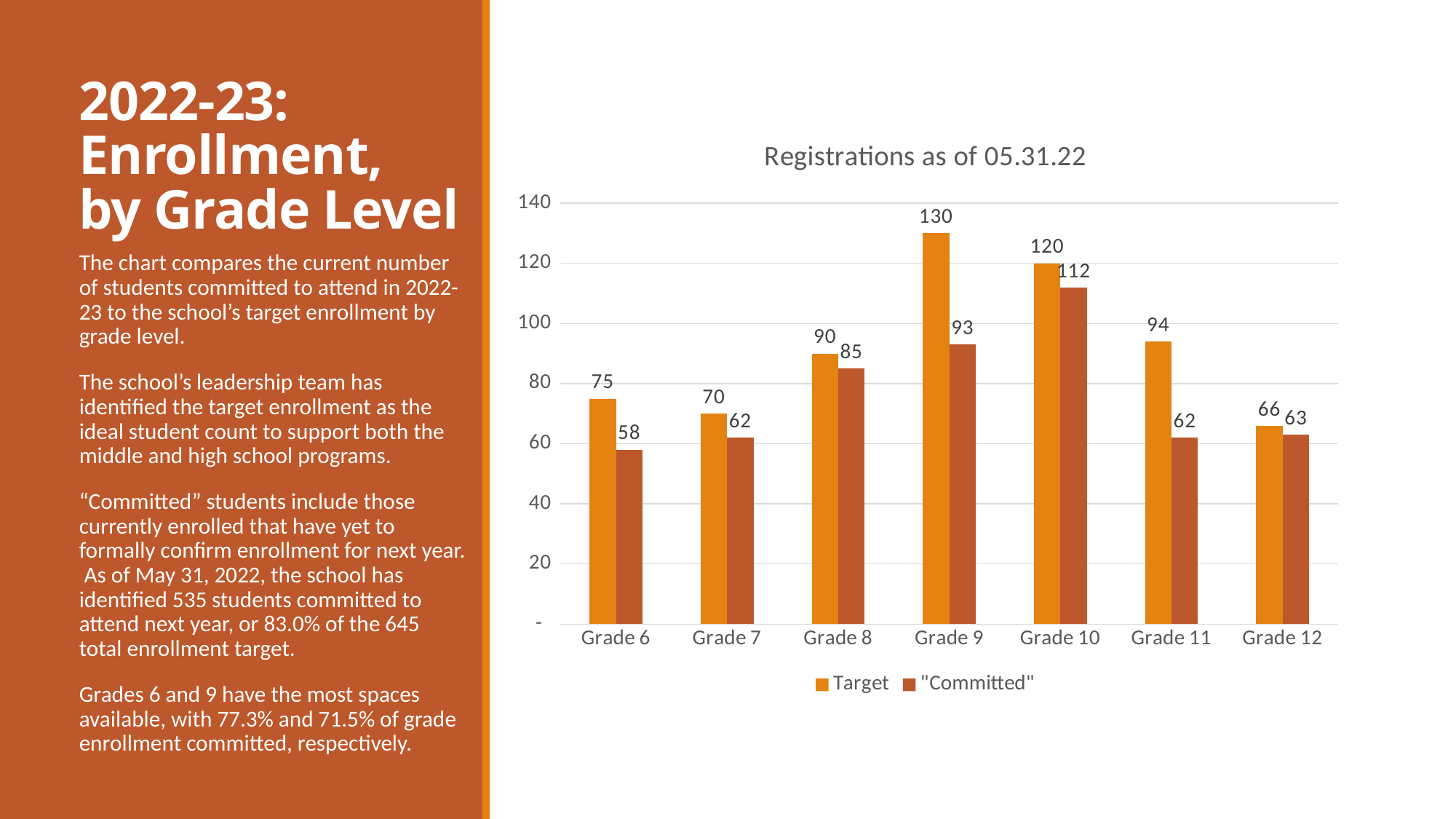
What is the Target value for Grade 9? 130 What is the difference between the Target and "Committed" values for Grade 11? 32 What kind of chart is shown on the slide? Bar chart What is the difference between the Target and "Committed" values for Grade 9? 37 What is the "Committed" value for Grade 6? 58 How many grade levels are shown on the x axis? 7 How many series does the legend list? 2 Which grade has the highest Target value? Grade 9 Which is larger for Grade 8: the Target value or the "Committed" value? Target What is the title of the chart? Registrations as of 05.31.22 What is the "Committed" value for Grade 10? 112 Which grade has the lowest "Committed" value? Grade 6